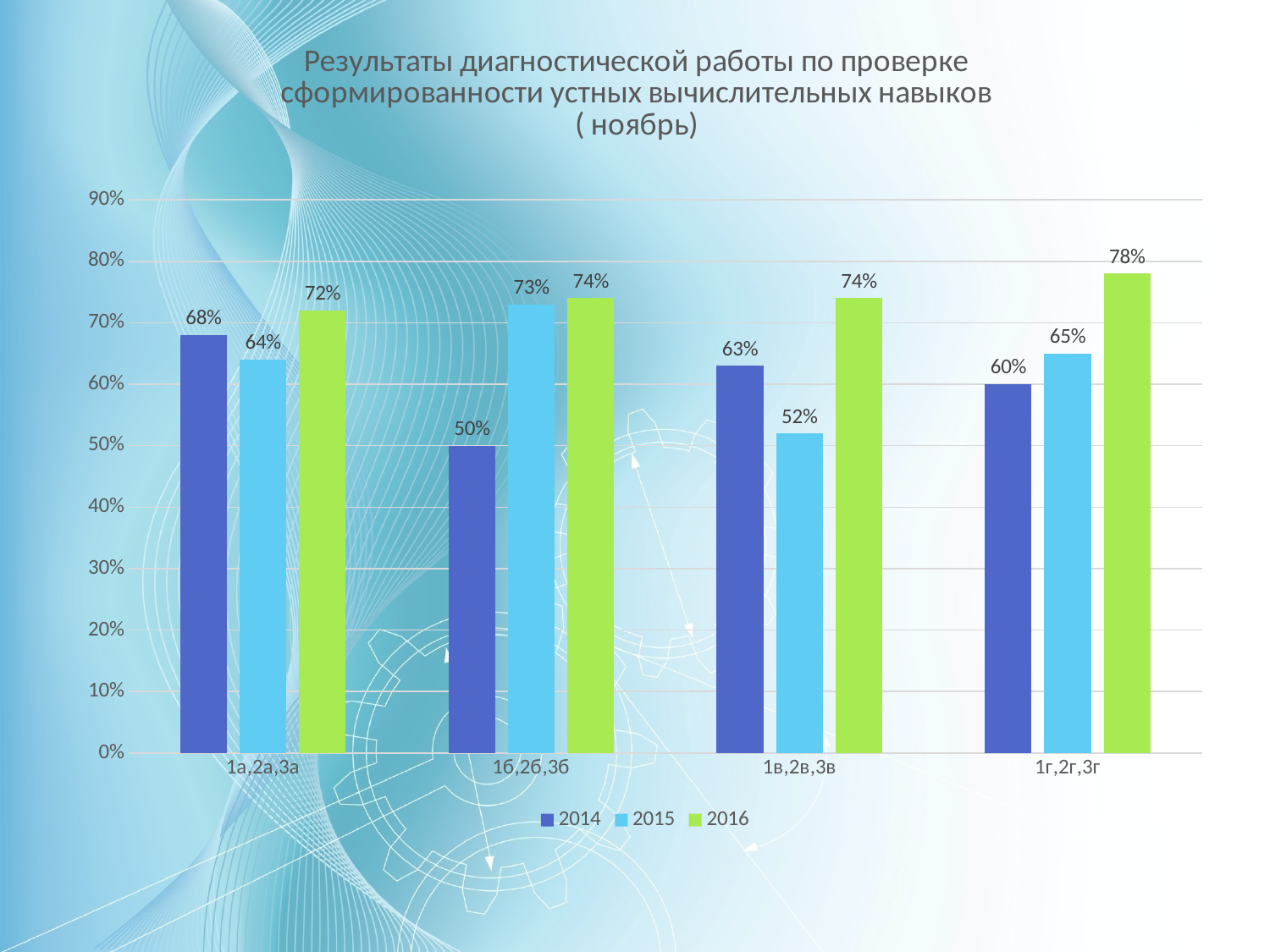
Which colour represents the 2016 series in the legend? green What is the value for 2015 in the 1в,2в,3в category? 52% What is the difference between the 2016 and 2014 values in the 1б,2б,3б category? 24% Is the value for 2015 in the 1г,2г,3г category greater or less than 60%? greater What is the value for 2014 in the 1б,2б,3б category? 50% What is the value for 2016 in the 1а,2а,3а category? 72% What kind of chart is shown on the slide? bar chart How many series does the legend list? 3 Which is larger in the 1а,2а,3а category: the 2014 value or the 2015 value? 2014 How many categories are shown on the x axis? 4 Which category has the highest value for the 2016 series? 1г,2г,3г Which category has the lowest value for the 2014 series? 1б,2б,3б